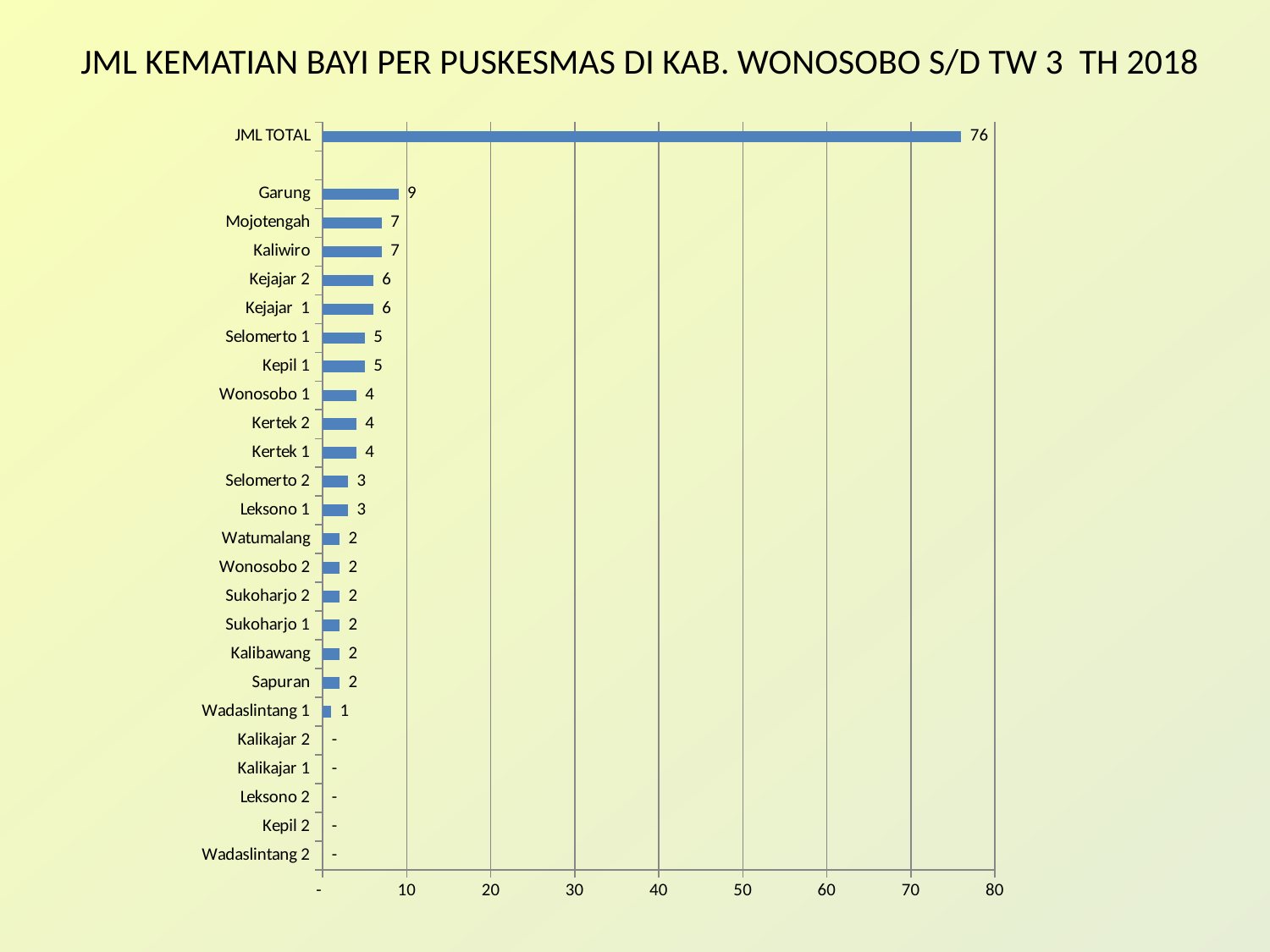
What is the value shown for JML TOTAL? 76 What kind of chart is shown on the slide? Bar chart Is the value for JML TOTAL greater or less than 70? greater What is the difference between the values for Garung and Mojotengah? 2 What is the difference between JML TOTAL and the value for Garung? 67 Which has a larger value, Kejajar 2 or Selomerto 1? Kejajar 2 What is the value for Wadaslintang 1? 1 What is the title of the chart? JML KEMATIAN BAYI PER PUSKESMAS DI KAB. WONOSOBO S/D TW 3 TH 2018 How many infant deaths are shown for Garung? 9 How many puskesmas show a value of "-" (no deaths)? 5 Excluding JML TOTAL, which puskesmas has the highest value? Garung What value is shown for Kepil 1? 5